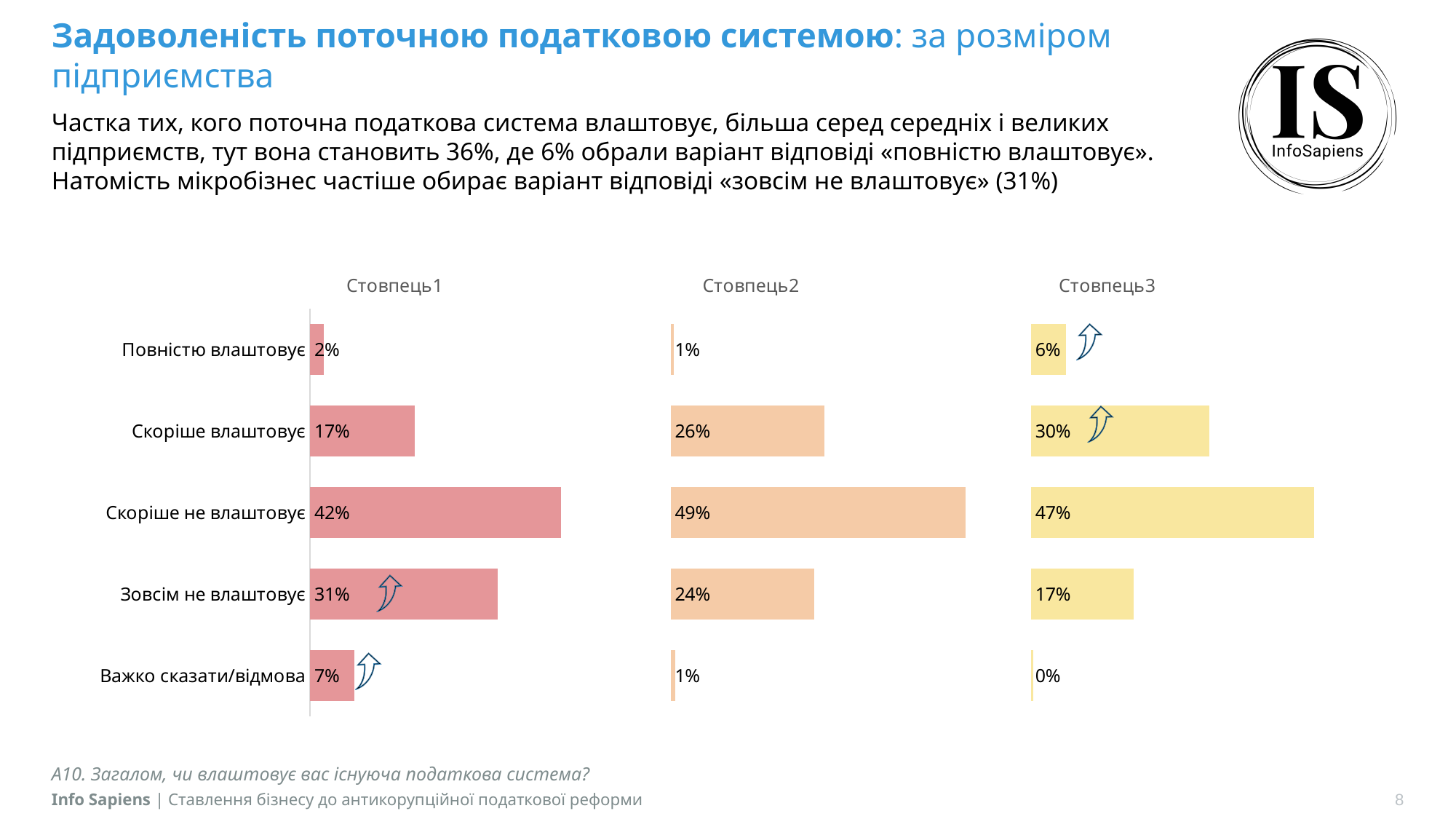
In the chart titled Стовпець3, which category has the lowest value? Важко сказати/відмова In the chart titled Стовпець3, what is the value for Повністю влаштовує? 6% How many categories are shown in the chart titled Стовпець1? 5 Which is larger: Зовсім не влаштовує in the chart titled Стовпець1 or Зовсім не влаштовує in the chart titled Стовпець3? Стовпець1 In the chart titled Стовпець1, what is the value for Скоріше не влаштовує? 42% In the chart titled Стовпець1, what is the difference between Скоріше не влаштовує and Скоріше влаштовує? 25% In the chart titled Стовпець2, what is the value for Скоріше влаштовує? 26% What kind of chart is the chart titled Стовпець2? Bar chart How many separate bar charts are shown on the slide? 3 In the chart titled Стовпець3, what is the value for Зовсім не влаштовує? 17% In the chart titled Стовпець1, which category has the highest value? Скоріше не влаштовує In the chart titled Стовпець2, what is the difference between Скоріше не влаштовує and Зовсім не влаштовує? 25%